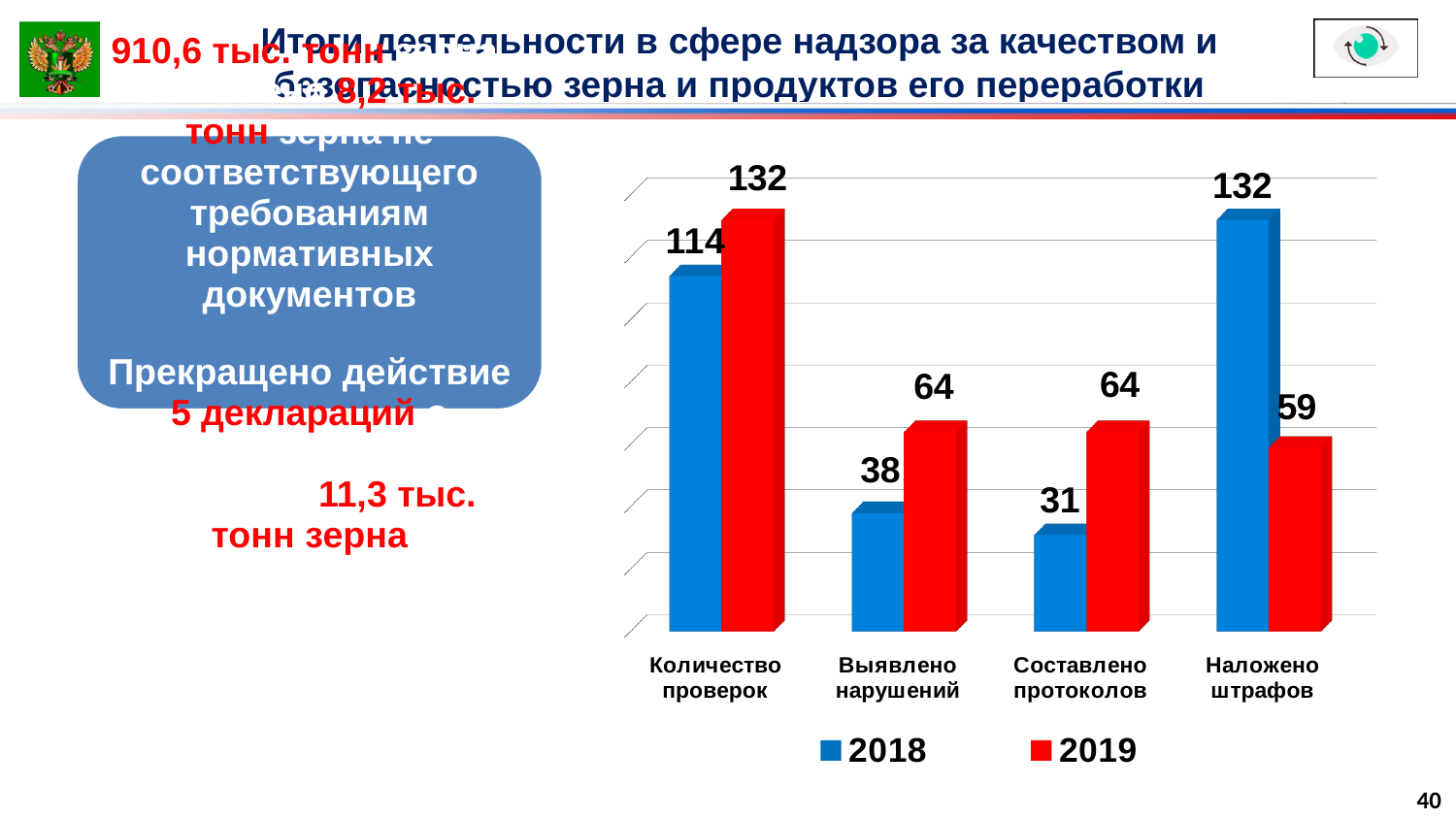
How many categories are shown on the x axis of the chart? 4 What kind of chart is shown on the slide? Bar chart What is the 2019 value for Наложено штрафов? 59 What is the difference between the 2018 and 2019 values for Наложено штрафов? 73 What is the 2018 value for Количество проверок? 114 Which category has the lowest 2018 value? Составлено протоколов What is the difference between the 2019 and 2018 values for Выявлено нарушений? 26 Which category has the highest 2018 value? Наложено штрафов For Количество проверок, which year has the larger value, 2018 or 2019? 2019 How many series does the chart legend list? 2 What is the 2019 value for Выявлено нарушений? 64 What is the 2018 value for Составлено протоколов? 31